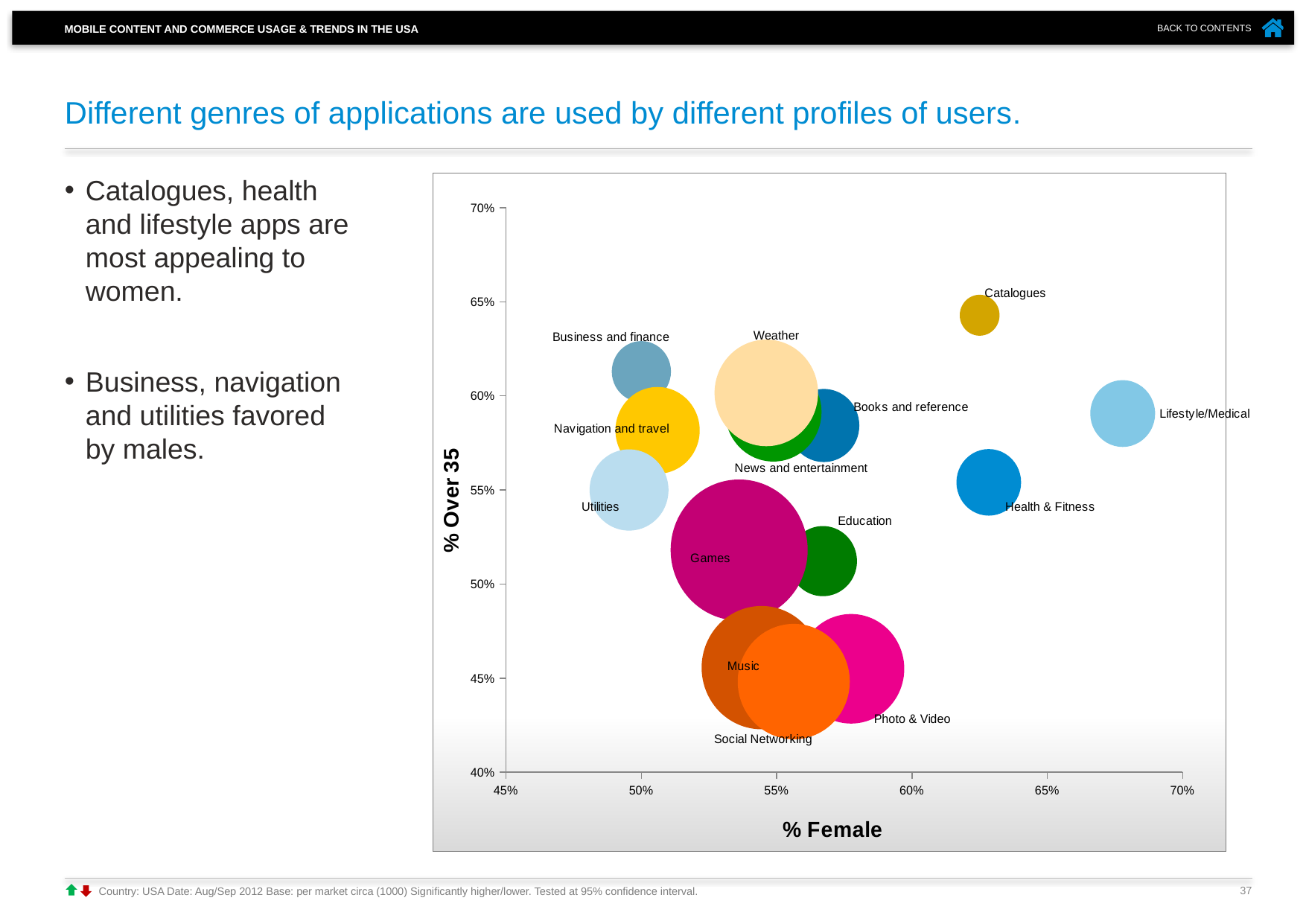
Which bubble is the largest on the chart? Games What is the label of the horizontal axis of the chart? % Female Which application genre has the highest % Female? Lifestyle/Medical What kind of chart is shown on the slide? Bubble chart Is the % Female value for Lifestyle/Medical greater or less than 65%? greater How many application genres (bubbles) are plotted on the chart? 14 Is the % Over 35 value for Games greater or less than 55%? less Is the % Female value for Health & Fitness greater or less than 60%? greater Which has a higher % Over 35, Catalogues or Games? Catalogues Which application genre has the highest % Over 35? Catalogues